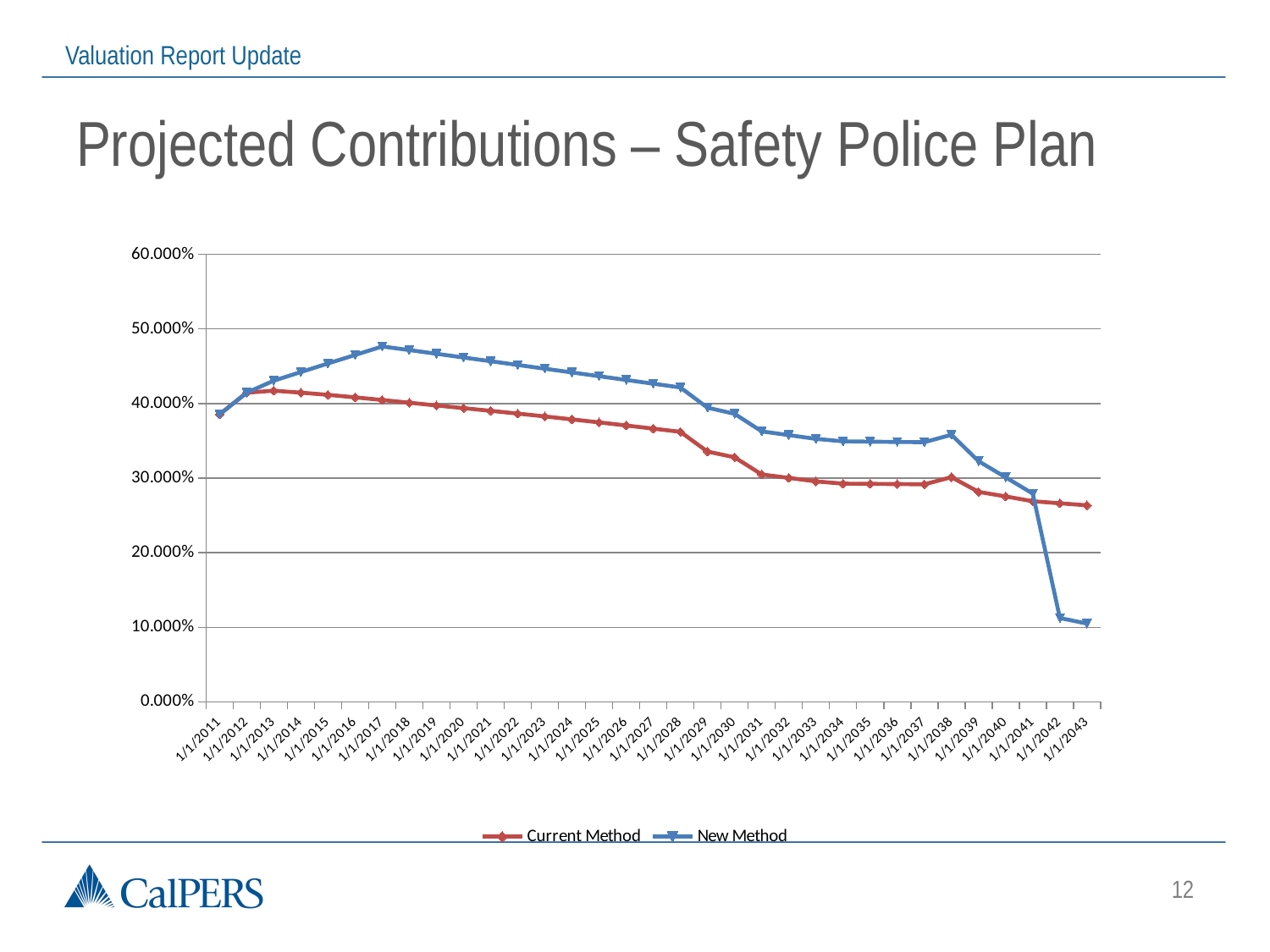
Is the value for New Method at 1/1/2043 greater or less than 20.000%? less How many series does the legend list? 2 At 1/1/2043, which series has the higher value, Current Method or New Method? Current Method At which date does the New Method series reach its highest value? 1/1/2017 Is the value for New Method at 1/1/2035 greater or less than 40.000%? less What are the two series named in the legend? Current Method and New Method How many dates are plotted along the x axis? 33 At which date does the New Method series reach its lowest value? 1/1/2043 At 1/1/2030, which series has the higher value, Current Method or New Method? New Method Is the value for Current Method at 1/1/2043 greater or less than 20.000%? greater What kind of chart is shown on the slide? line chart